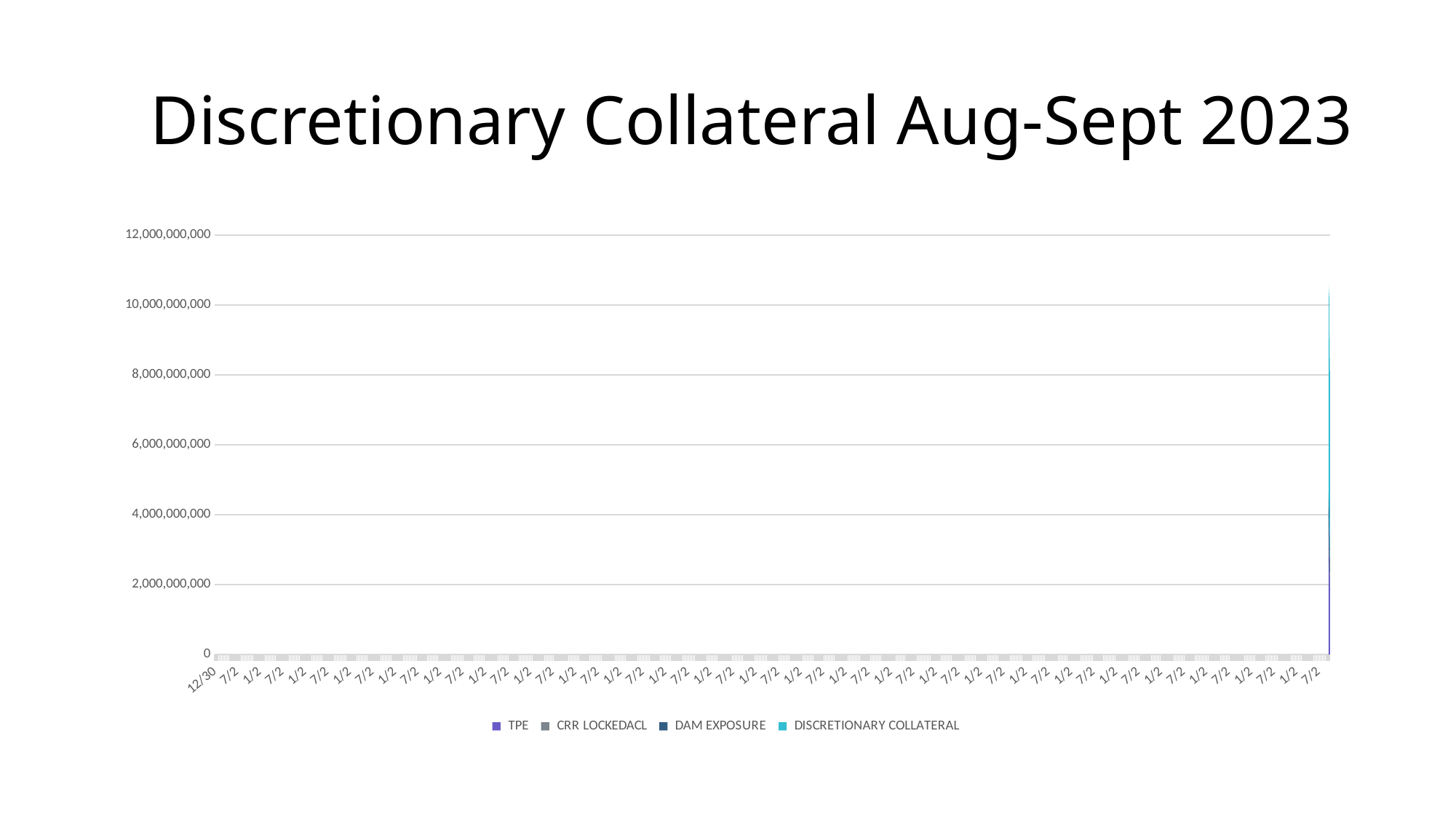
What is the title of the chart? Discretionary Collateral Aug-Sept 2023 Which series is shown in cyan in the legend? DISCRETIONARY COLLATERAL Is the highest point reached by the plotted data greater or less than 8,000,000,000? greater How many series does the legend list? 4 Is the highest point reached by the plotted data greater or less than 12,000,000,000? less